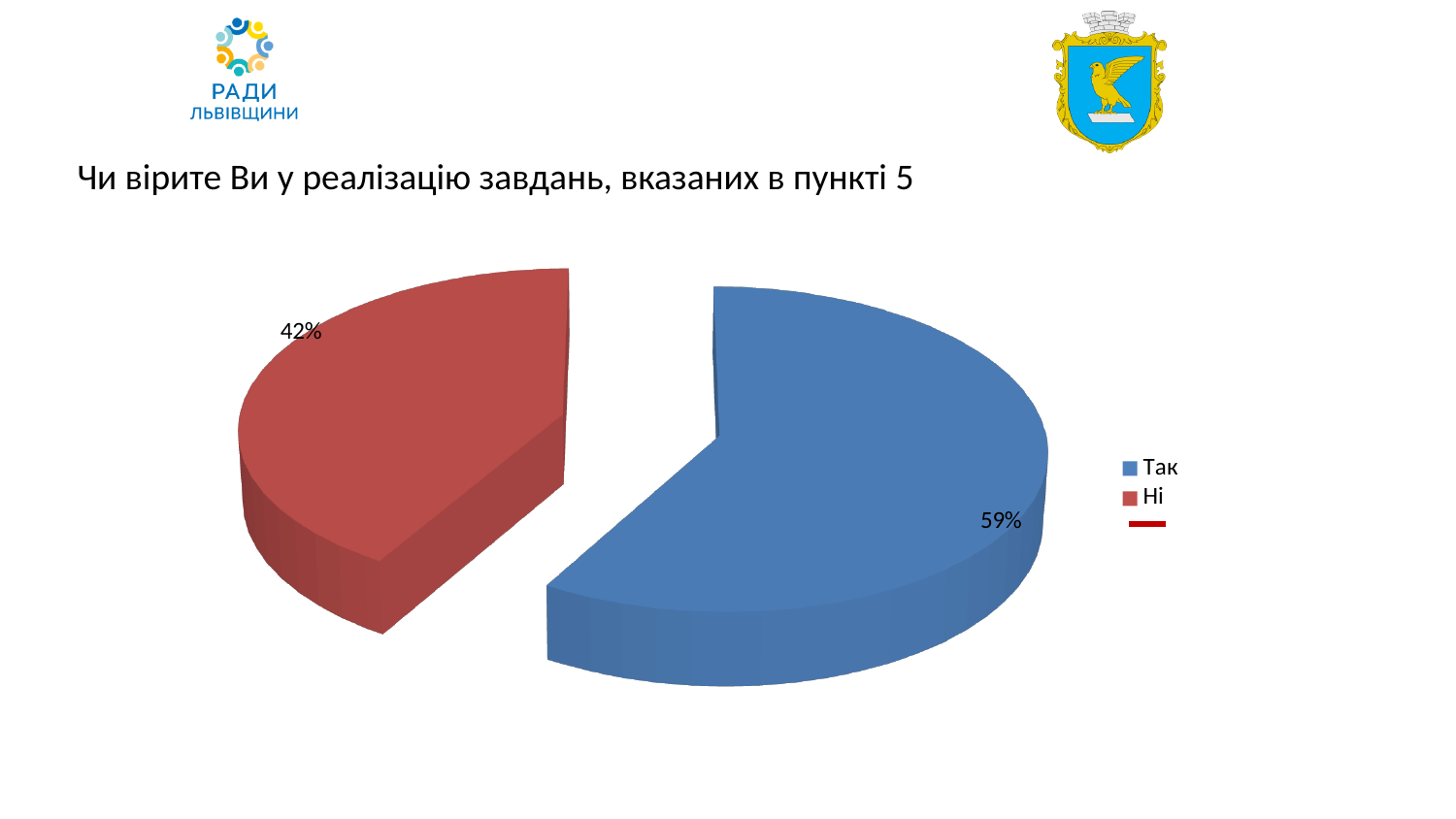
Which category has the largest slice of the pie? Так What share of the pie does the "Так" slice represent? 59% How many slices does the pie chart have? 2 What is the title of the chart on the slide? Чи вірите Ви у реалізацію завдань, вказаних в пункті 5 What is the value shown for the "Ні" category? 42% Which category has the smallest slice of the pie? Ні By how many percentage points does the "Так" value exceed the "Ні" value? 17 percentage points What colour is the "Так" slice? Blue What kind of chart is shown on the slide? Pie chart Which is larger, the "Так" slice or the "Ні" slice? Так What is the value shown for the "Так" category? 59% What share of the pie does the "Ні" slice represent? 42%